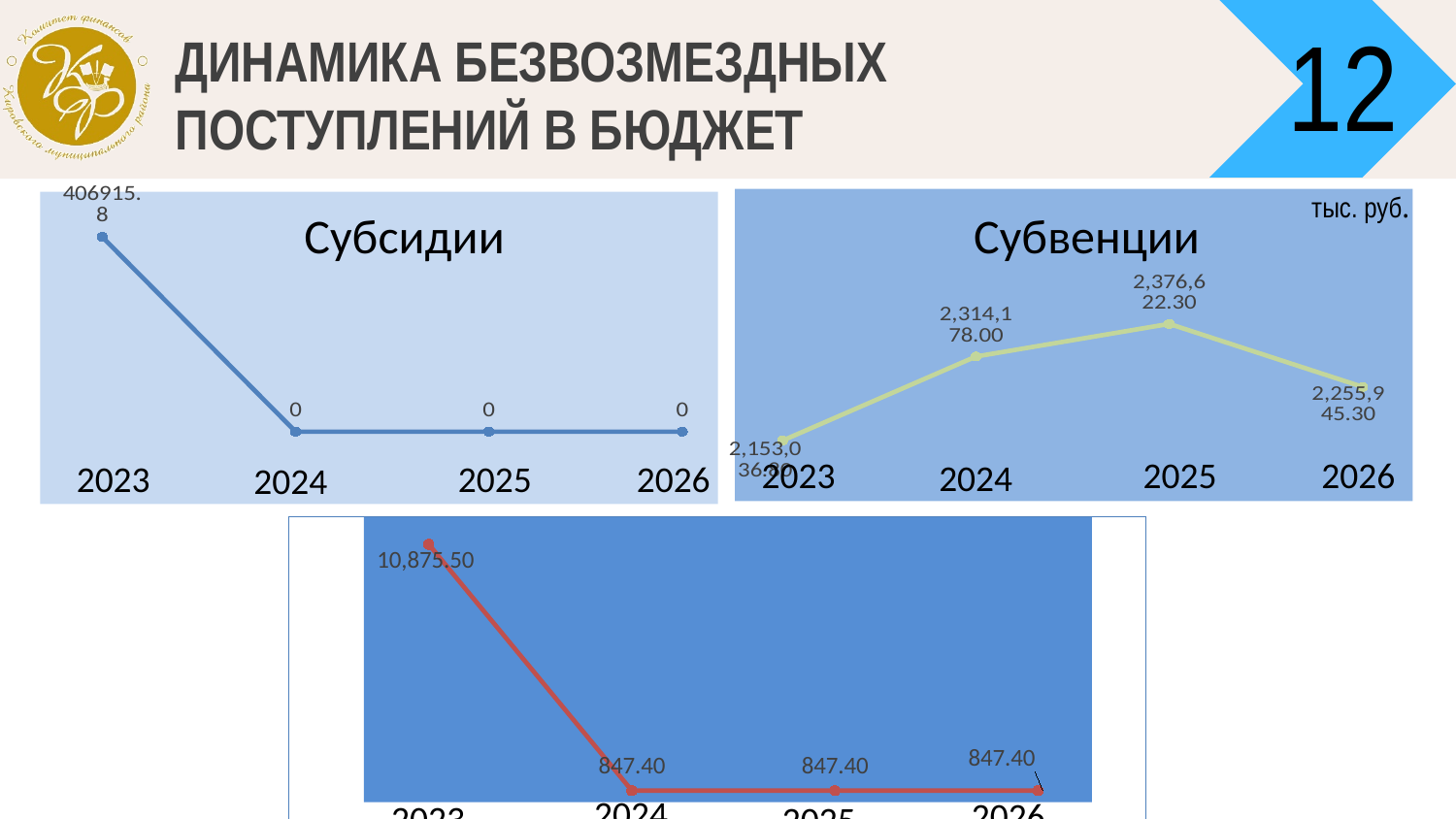
In the Субвенции chart, which year has the lowest value? 2023 In the Субвенции chart, which year has the highest value? 2025 In the bottom chart, what is the difference between the values for 2023 and 2024? 10,028.10 In the Субсидии chart, what is the value for 2023? 406915.8 What kind of chart is the Субсидии chart? line chart In the Субвенции chart, which is larger, the value for 2024 or the value for 2026? 2024 In the Субвенции chart, what is the value for 2025? 2,376,622.30 In the Субвенции chart, what is the value for 2026? 2,255,945.30 In the bottom chart, what is the value for 2023? 10,875.50 In the bottom chart, what is the value for 2025? 847.40 In the Субсидии chart, which year has the highest value? 2023 In the Субсидии chart, what is the value for 2025? 0